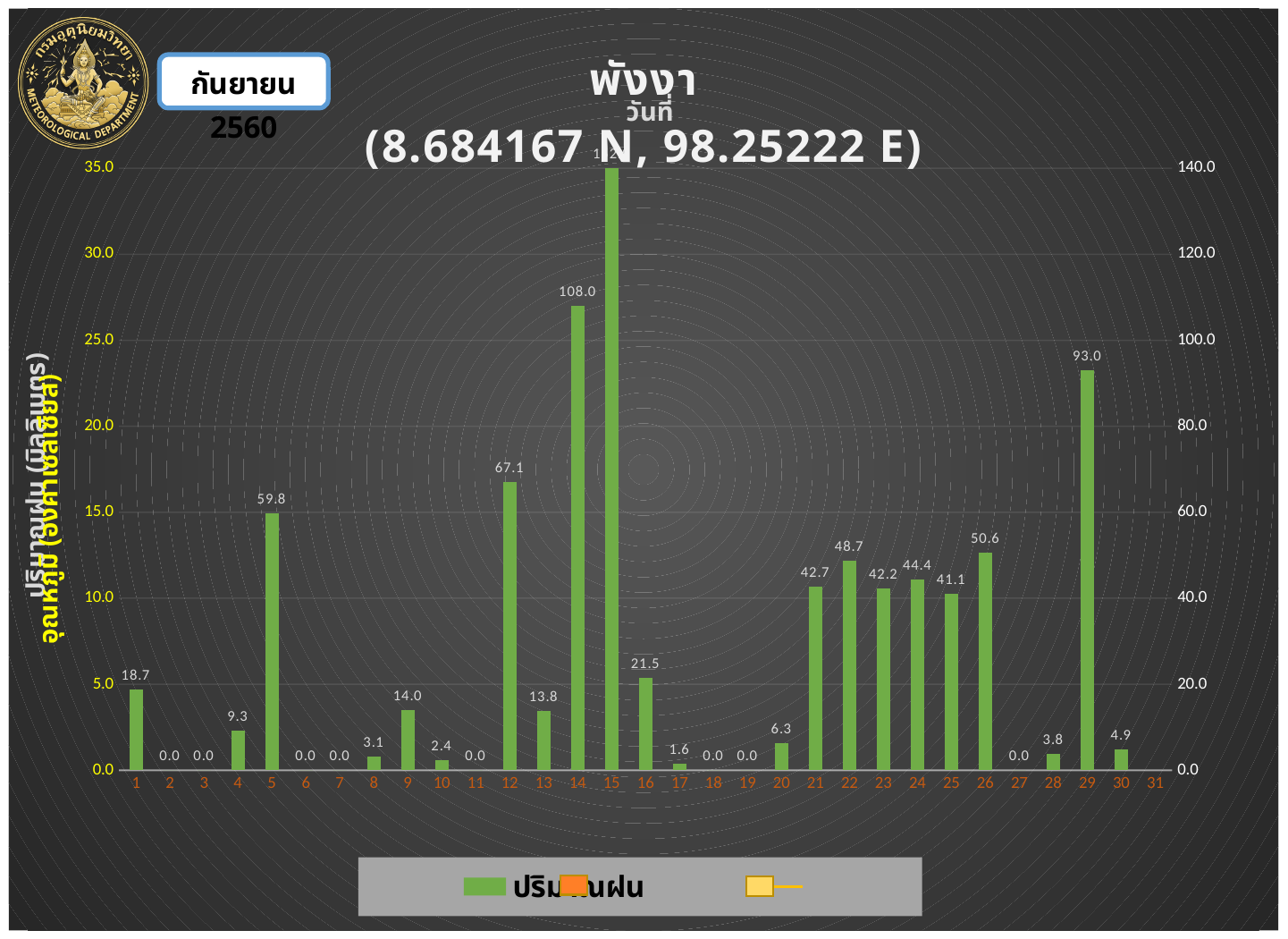
How many entries does the legend list? 3 Which day has more rainfall, day 26 or day 21? 26 What is the rainfall value for day 22? 48.7 How many days are shown on the x axis? 31 What kind of chart is this? bar chart What is the rainfall value for day 5? 59.8 What is the rainfall value for day 1? 18.7 What is the rainfall value for day 29? 93.0 What is the rainfall value for day 14? 108.0 Is the rainfall value for day 29 greater or less than 80.0 on the right axis? greater Which day has the highest rainfall bar? 15 What is the difference between the rainfall on day 14 and day 12? 40.9